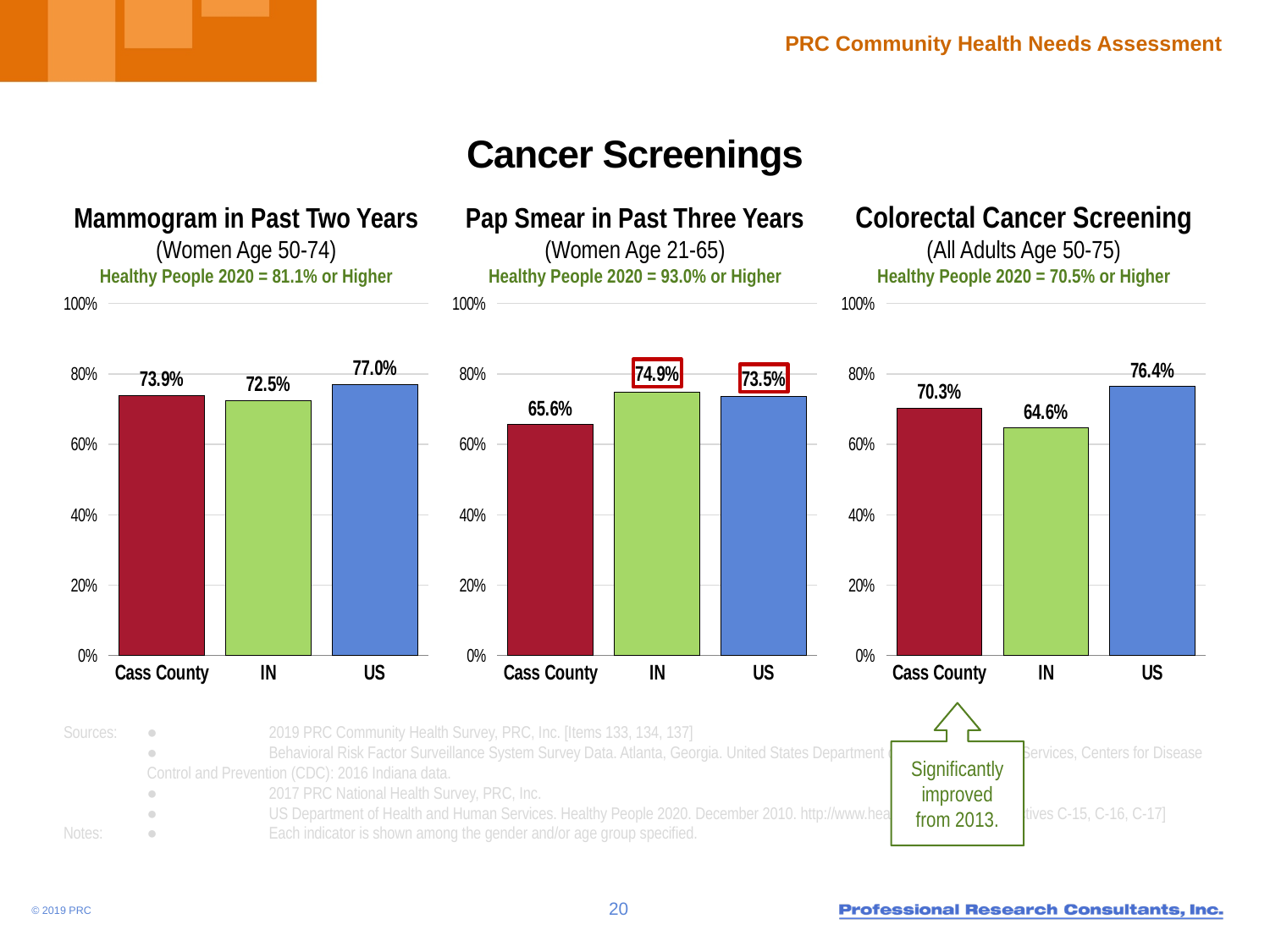
In the 'Colorectal Cancer Screening' chart, which is larger, the value for Cass County or the value for IN? Cass County In the 'Pap Smear in Past Three Years' chart, which category has the lowest value? Cass County In the 'Mammogram in Past Two Years' chart, what is the value for Cass County? 73.9% In the 'Mammogram in Past Two Years' chart, is the value for IN greater or less than 80%? less In the 'Pap Smear in Past Three Years' chart, what is the difference between the IN value and the Cass County value? 9.3% In the 'Colorectal Cancer Screening' chart, which category has the lowest value? IN How many categories are shown in the 'Colorectal Cancer Screening' chart? 3 In the 'Mammogram in Past Two Years' chart, which category has the highest value? US What is the Healthy People 2020 target shown under the 'Colorectal Cancer Screening' chart title? 70.5% or Higher In the 'Pap Smear in Past Three Years' chart, what is the value for IN? 74.9% In the 'Colorectal Cancer Screening' chart, what is the value for US? 76.4% What kind of chart is the 'Pap Smear in Past Three Years' chart? bar chart